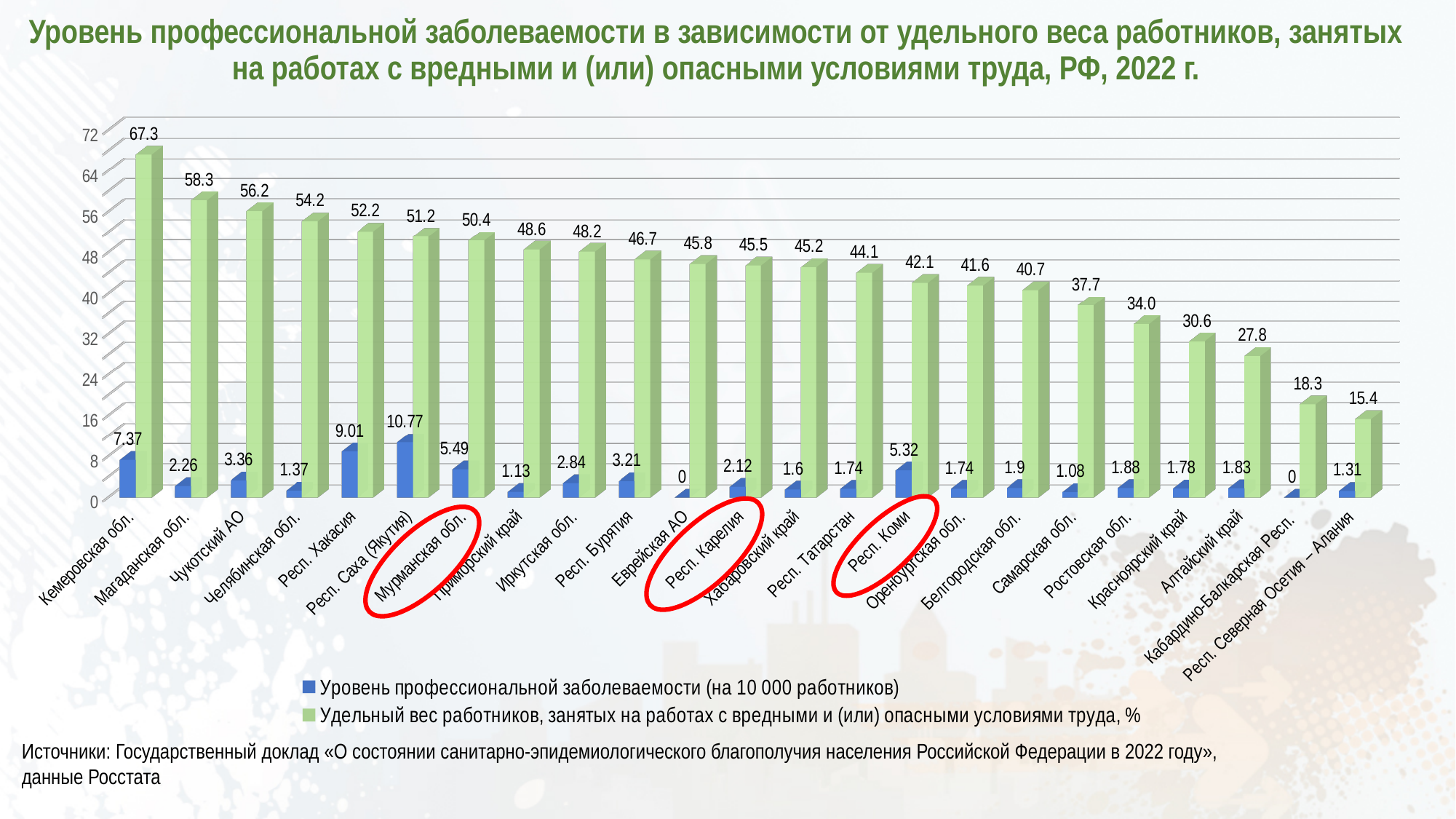
Do the green-bar values rise or fall from left to right along the x axis? Fall What is the occupational disease rate (blue bar) for Мурманская обл.? 5.49 What is the share of workers employed in harmful and/or hazardous working conditions (green bar) for Кемеровская обл.? 67.3 How many regions are shown on the x axis of the chart? 23 What is the occupational disease rate (per 10 000 workers, blue bar) for Респ. Саха (Якутия)? 10.77 Which region has the highest occupational disease rate (blue series)? Респ. Саха (Якутия) How many series does the legend list? 2 Is the green-bar value for Ростовская обл. greater or less than 32? greater What is the difference between the green-bar values for Кемеровская обл. and Магаданская обл.? 9.0 What kind of chart is shown on the slide? Bar chart Which has a higher occupational disease rate (blue bar): Респ. Хакасия or Респ. Коми? Респ. Хакасия Which region has the lowest share of workers in harmful and/or hazardous conditions (green series)? Респ. Северная Осетия – Алания